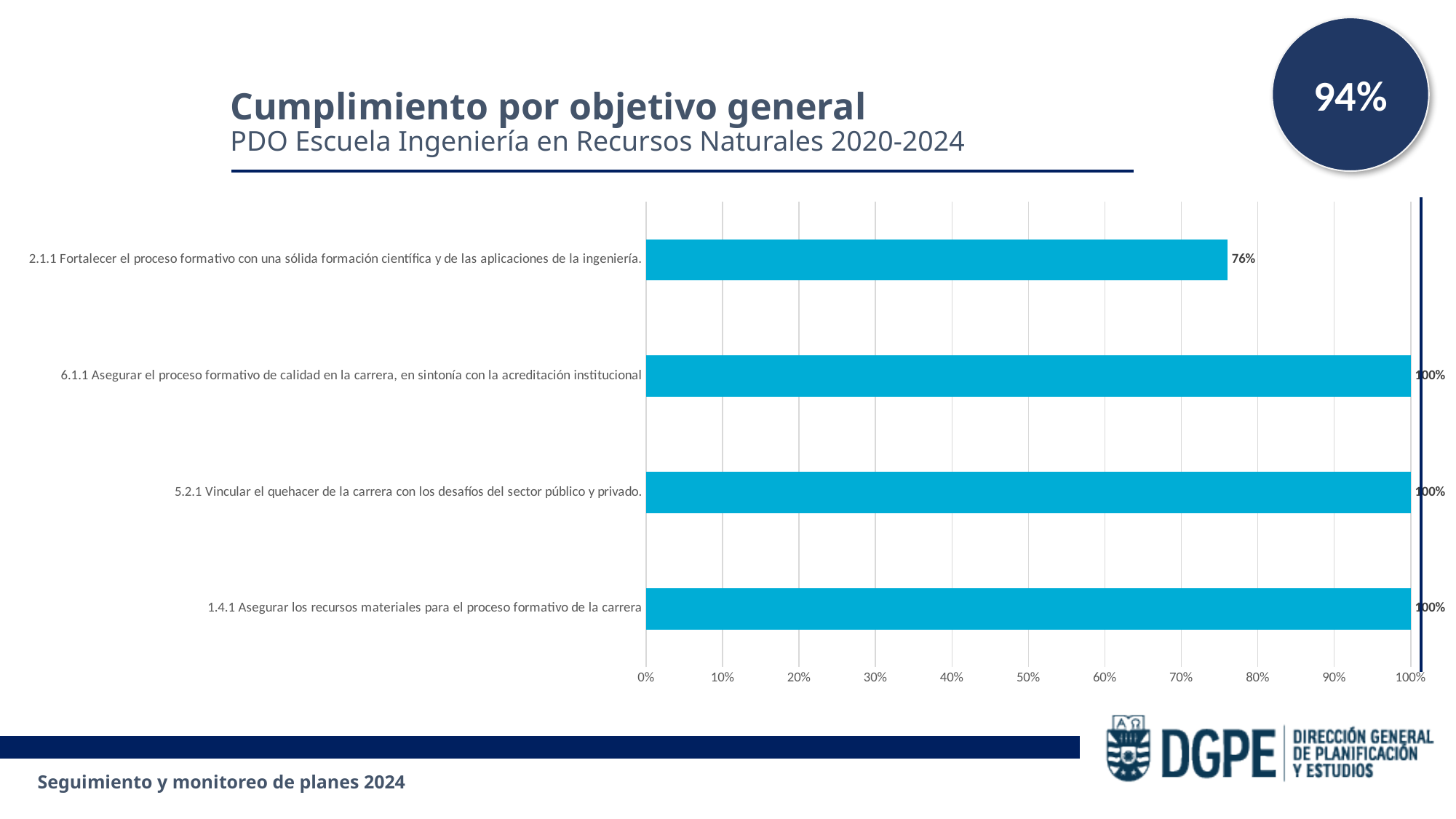
How many objectives reached 100%? 3 What kind of chart is shown on the slide? bar chart Is the value for objective 2.1.1 greater or less than 70%? greater How many objectives (bars) are shown in the chart? 4 What overall percentage is shown in the circle at the top right of the slide? 94% Which is larger, the value for objective 2.1.1 or the value for objective 5.2.1? 5.2.1 What is the value for objective 5.2.1 (Vincular el quehacer de la carrera con los desafíos del sector público y privado)? 100% Which objective has the lowest compliance value? 2.1.1 Fortalecer el proceso formativo con una sólida formación científica y de las aplicaciones de la ingeniería. What is the value for objective 1.4.1 (Asegurar los recursos materiales para el proceso formativo de la carrera)? 100% What is the value for objective 6.1.1 (Asegurar el proceso formativo de calidad en la carrera, en sintonía con la acreditación institucional)? 100% What is the difference between the value for objective 6.1.1 and the value for objective 2.1.1? 24% What is the value for objective 2.1.1 (Fortalecer el proceso formativo con una sólida formación científica y de las aplicaciones de la ingeniería)? 76%